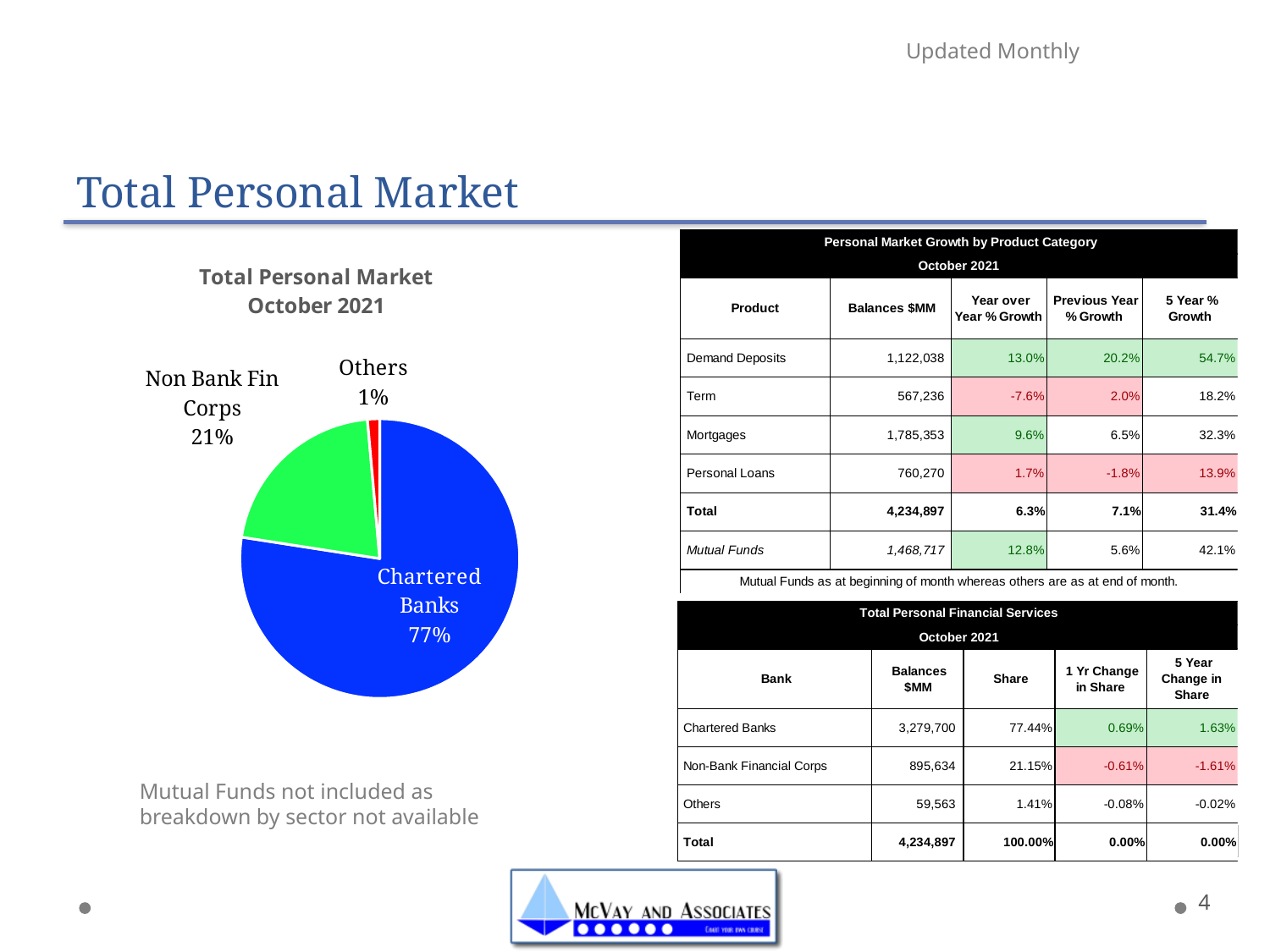
What colour is the Chartered Banks slice in the pie chart? Blue What share of the pie chart does Others hold? 1% What share of the pie chart does Non Bank Fin Corps hold? 21% What share of the pie chart does Chartered Banks hold? 77% Which slice of the pie chart is the largest? Chartered Banks What is the title of the pie chart? Total Personal Market October 2021 What kind of chart is shown on the slide? Pie chart How many percentage points larger is the Chartered Banks slice than the Non Bank Fin Corps slice? 56 percentage points How many slices does the pie chart have? 3 Which is larger in the pie chart, Non Bank Fin Corps or Others? Non Bank Fin Corps Which slice of the pie chart is the smallest? Others